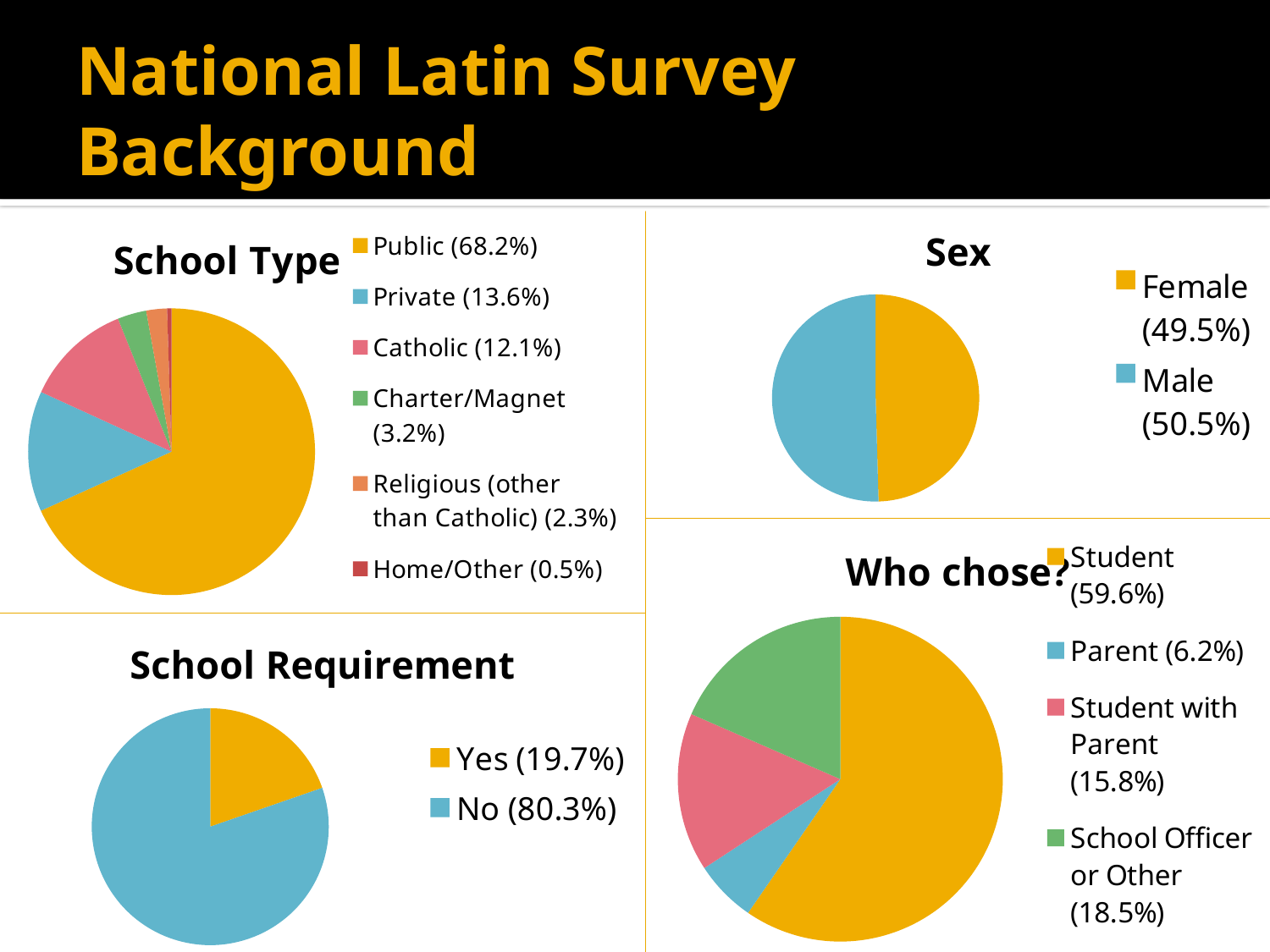
In the Sex chart, which category has the larger share, Female or Male? Male In the School Type chart, how many categories does the legend list? 6 In the Sex chart, what share of respondents are Male? 50.5% In the School Requirement chart, what is the difference between the No and Yes shares? 60.6% In the Who chose? chart, what share is Student with Parent? 15.8% In the Who chose? chart, which is larger, Parent or School Officer or Other? School Officer or Other In the School Type chart, what is the difference between the Private and Catholic shares? 1.5% In the School Requirement chart, what share answered No? 80.3% What kind of chart is the School Requirement chart? Pie chart In the School Type chart, which school type has the smallest share? Home/Other In the Who chose? chart, which category has the largest share? Student